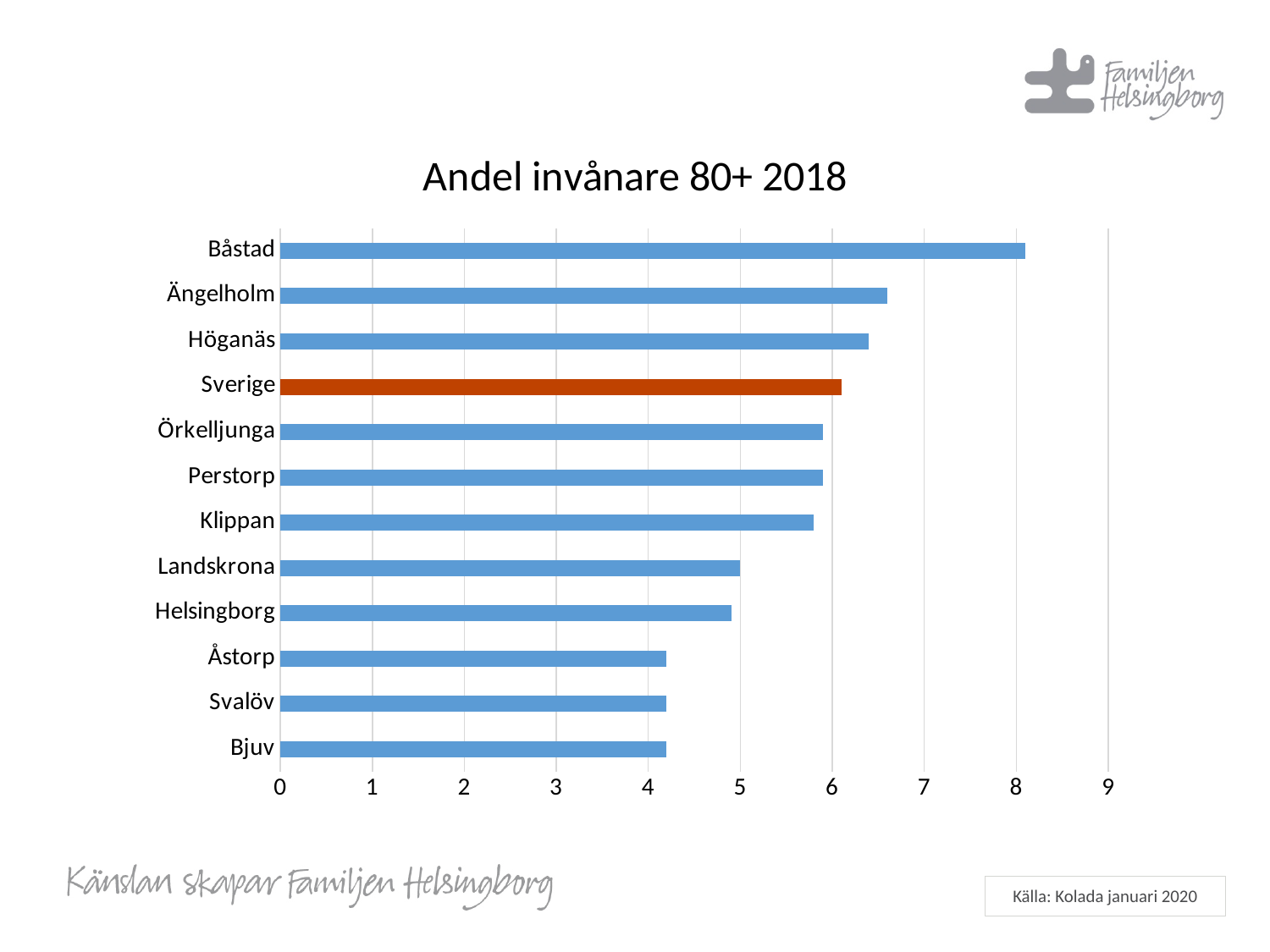
What kind of chart is shown on the slide? bar chart Is the value for Båstad greater or less than 8? greater How many categories are shown in the chart? 12 Which has a larger value, Sverige or Klippan? Sverige Is the value for Klippan greater or less than 6? less Which has a larger value, Höganäs or Helsingborg? Höganäs Is the value for Ängelholm greater or less than 6? greater Which category has the highest value? Båstad What is the title of the chart? Andel invånare 80+ 2018 Which bar is shown in a different colour from the others? Sverige